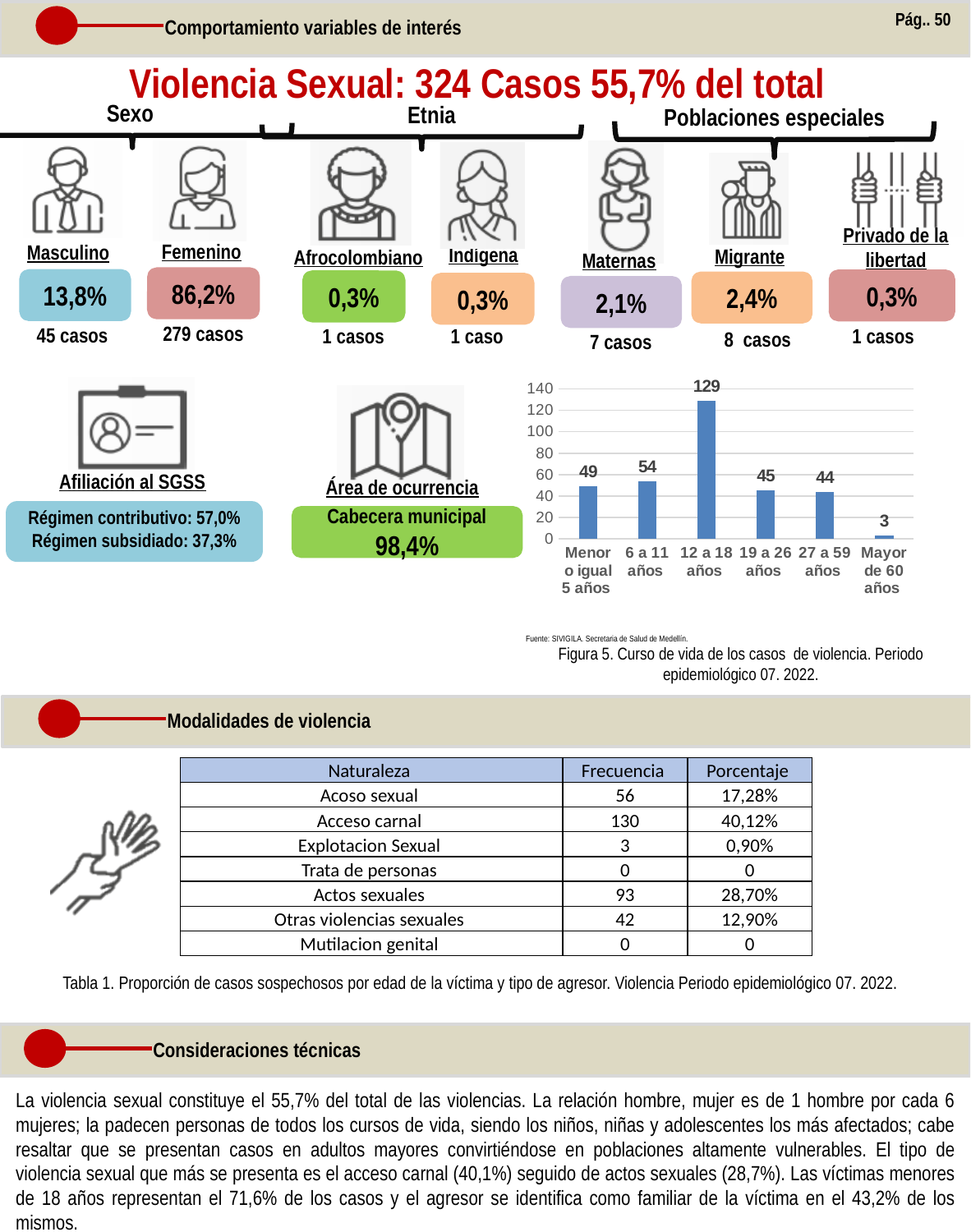
In the bar chart (Figura 5), how many age groups are shown on the x axis? 6 In the bar chart (Figura 5), do the values rise or fall from '12 a 18 años' to 'Mayor de 60 años'? fall In the bar chart (Figura 5), what is the value for the '27 a 59 años' age group? 44 In the bar chart (Figura 5), what is the value for 'Menor o igual 5 años'? 49 In the bar chart (Figura 5), is the value for '12 a 18 años' greater or less than 100? greater In the bar chart (Figura 5), what is the value for the '12 a 18 años' age group? 129 In the bar chart (Figura 5), which age group has the highest number of cases? 12 a 18 años What is the caption of the bar chart on the slide? Figura 5. Curso de vida de los casos de violencia. Periodo epidemiológico 07. 2022. In the bar chart (Figura 5), which age group has the lowest number of cases? Mayor de 60 años What kind of chart is Figura 5 on the slide? bar chart In the bar chart (Figura 5), which is larger: the value for '6 a 11 años' or the value for '19 a 26 años'? 6 a 11 años In the bar chart (Figura 5), what is the difference between the values for '12 a 18 años' and '6 a 11 años'? 75